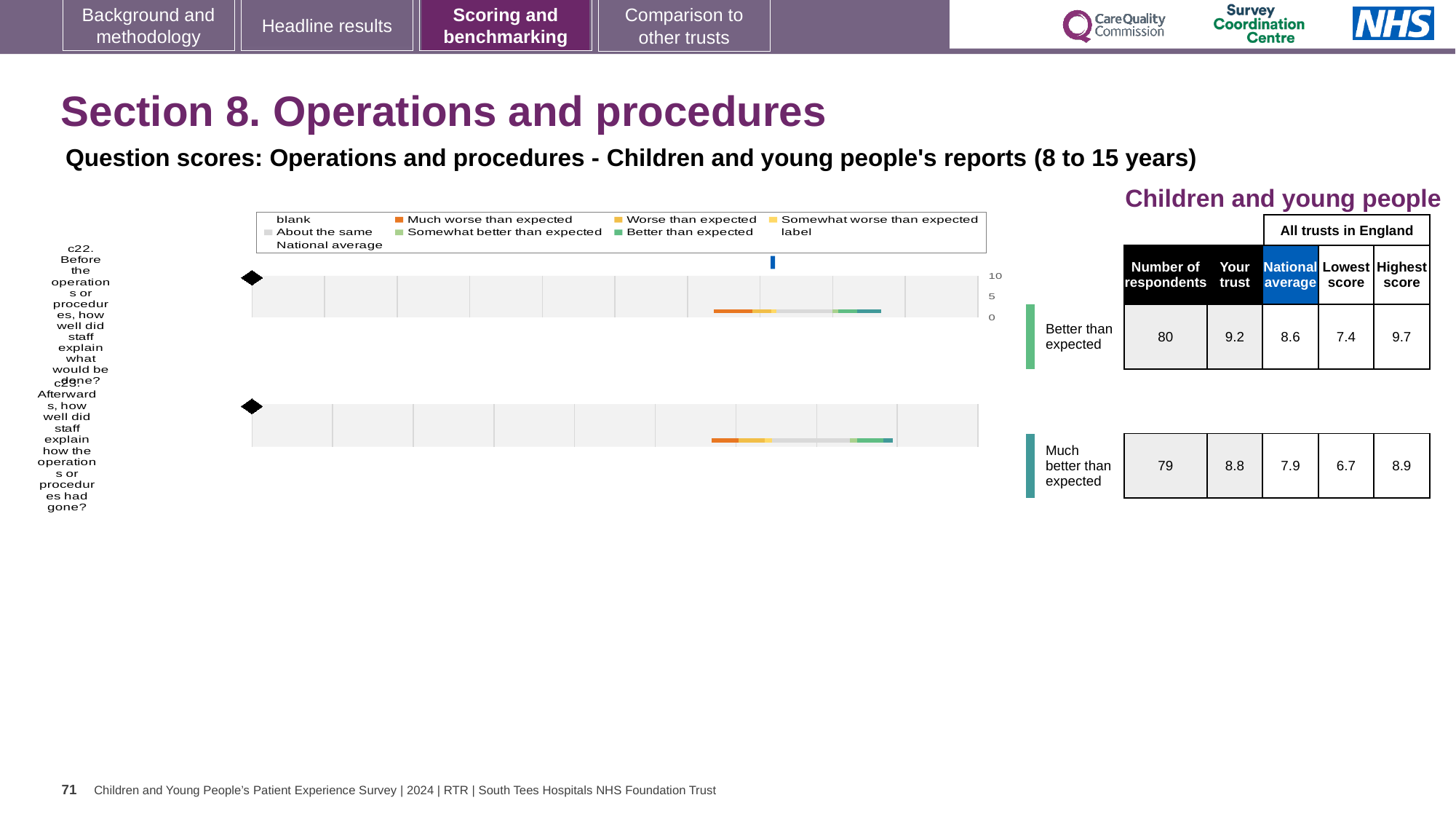
For question c22, what is the Lowest score among all trusts in England? 7.4 What kind of chart is used for the c22 and c23 question scores on this slide? bar chart For question c23 (Afterwards, how well did staff explain how the operations or procedures had gone?), how many respondents are shown? 79 For question c22, what is the National average score shown in the table? 8.6 For question c23, what is the difference between the Highest score and the Lowest score? 2.2 What benchmark category is shown for question c22 on this slide? Better than expected Which question has the higher 'Your trust' score, c22 or c23? c22 For question c22 (Before the operations or procedures, how well did staff explain what would be done?), what is the 'Your trust' score shown in the table? 9.2 For question c22, how much higher is the 'Your trust' score than the National average? 0.6 How many questions (rows) are plotted in the Operations and procedures chart on this slide? 2 What benchmark category is shown for question c23 on this slide? Much better than expected For question c23, what is the Highest score among all trusts in England? 8.9